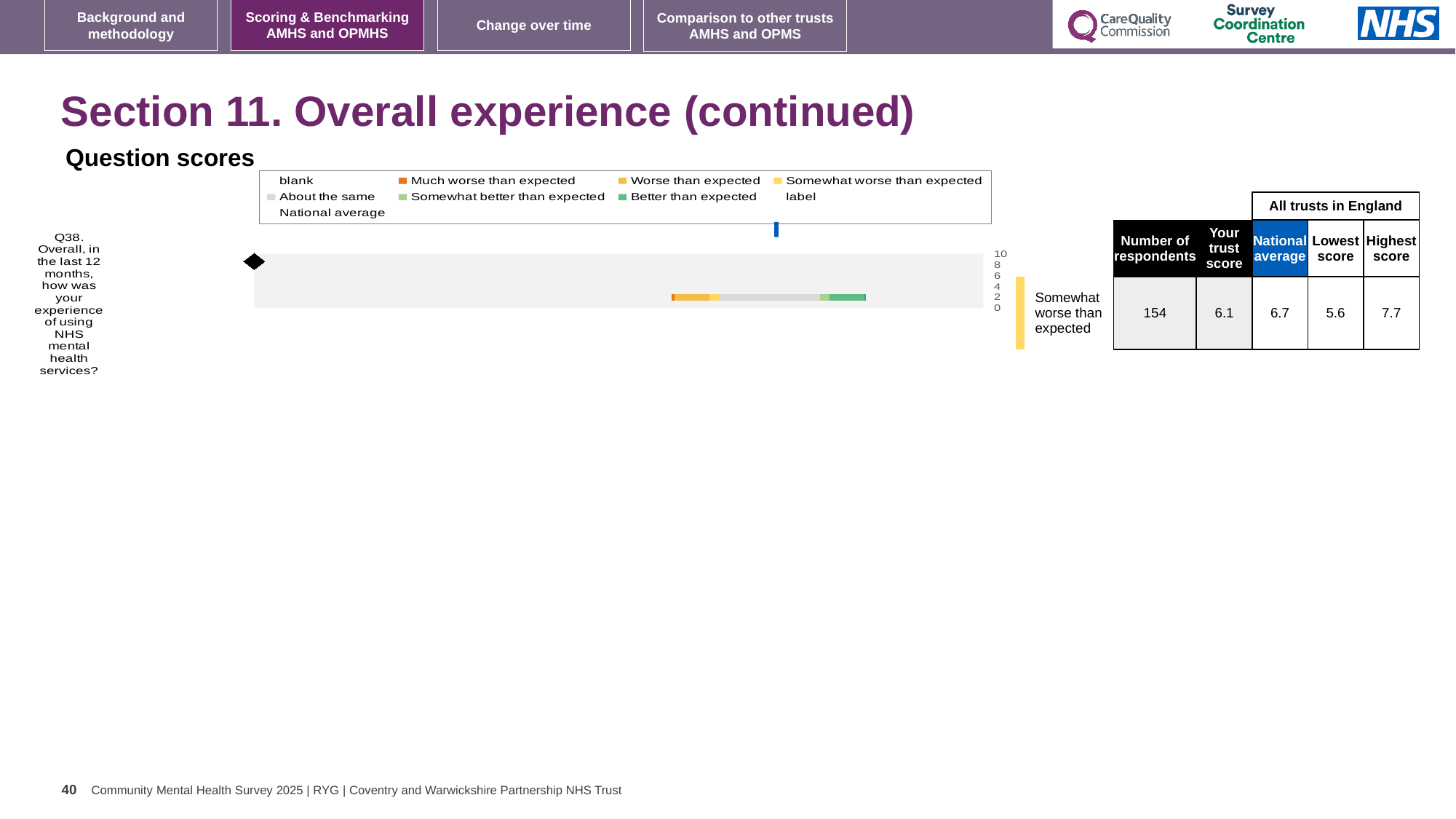
What is the national average score for Q38? 6.7 What is the highest score among all trusts in England for Q38? 7.7 What is the lowest score among all trusts in England for Q38? 5.6 Which benchmark category does the trust's Q38 score fall into? Somewhat worse than expected What is the difference between the highest and lowest trust scores for Q38? 2.1 What is the maximum value shown on the chart's score axis? 10 How many questions are plotted on the chart? 1 Which is larger for Q38: the trust's score or the national average? national average How many respondents answered Q38? 154 What is the trust's score for Q38 (Overall, in the last 12 months, how was your experience of using NHS mental health services?)? 6.1 What type of chart is used to show the Q38 question score? bar chart By how much is the national average higher than the trust's score for Q38? 0.6